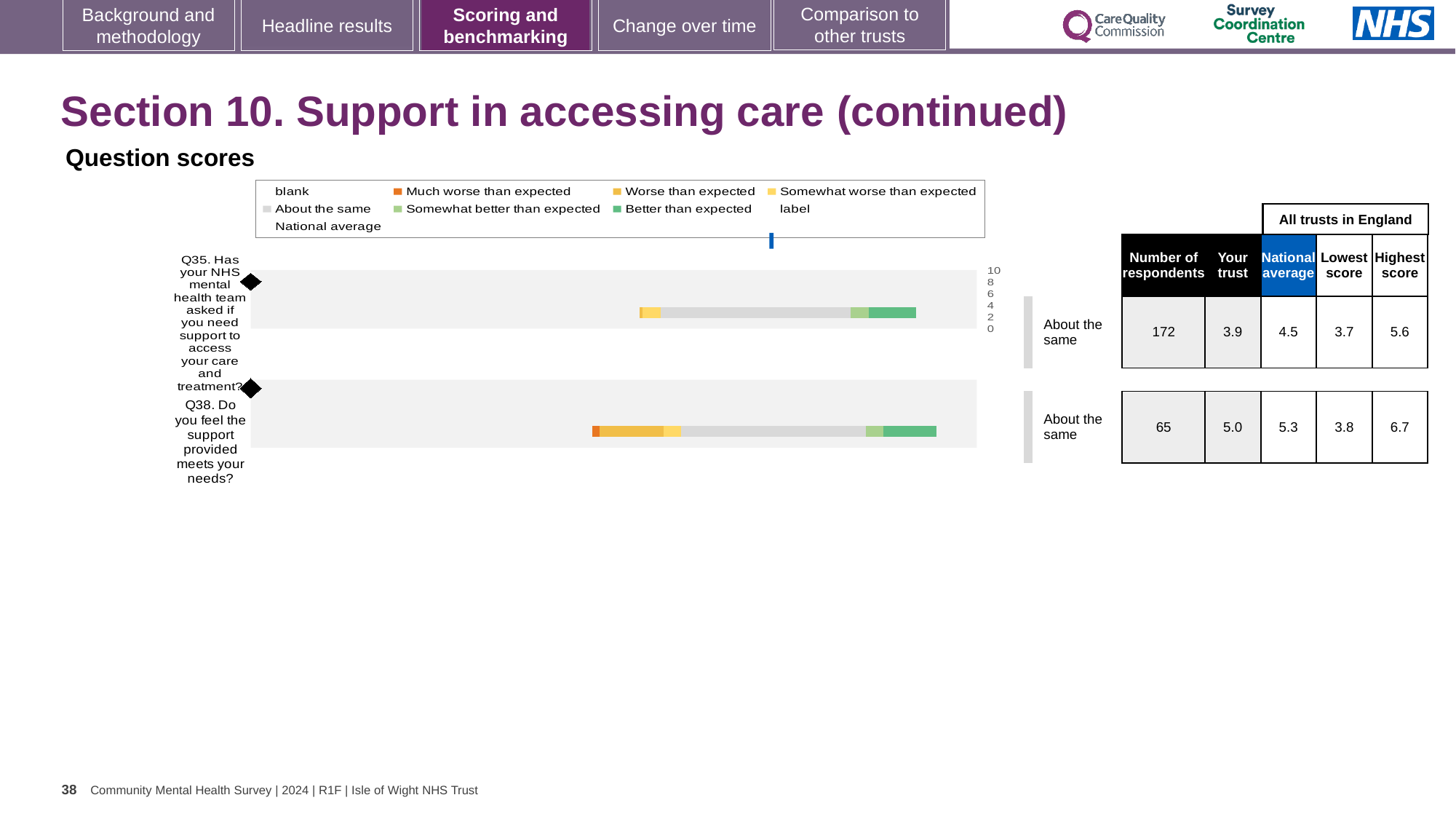
What is the difference between the national average and the 'Your trust' score for Q35? 0.6 Which question had more respondents, Q35 or Q38? Q35 How many respondents answered Q35? 172 What kind of chart is used to show the question scores on this slide? bar chart Which question has the higher 'Your trust' score, Q35 or Q38? Q38 What is the highest score across all trusts in England for Q35? 5.6 What colour represents 'Better than expected' in the chart legend? green What is the 'Your trust' score for Q35 (Has your NHS mental health team asked if you need support to access your care and treatment?)? 3.9 What is the national average score for Q38 (Do you feel the support provided meets your needs?)? 5.3 How many questions are plotted in the question scores chart? 2 What is the difference between the highest score and the lowest score for Q38? 2.9 What benchmark category is shown next to the bar for Q38? About the same